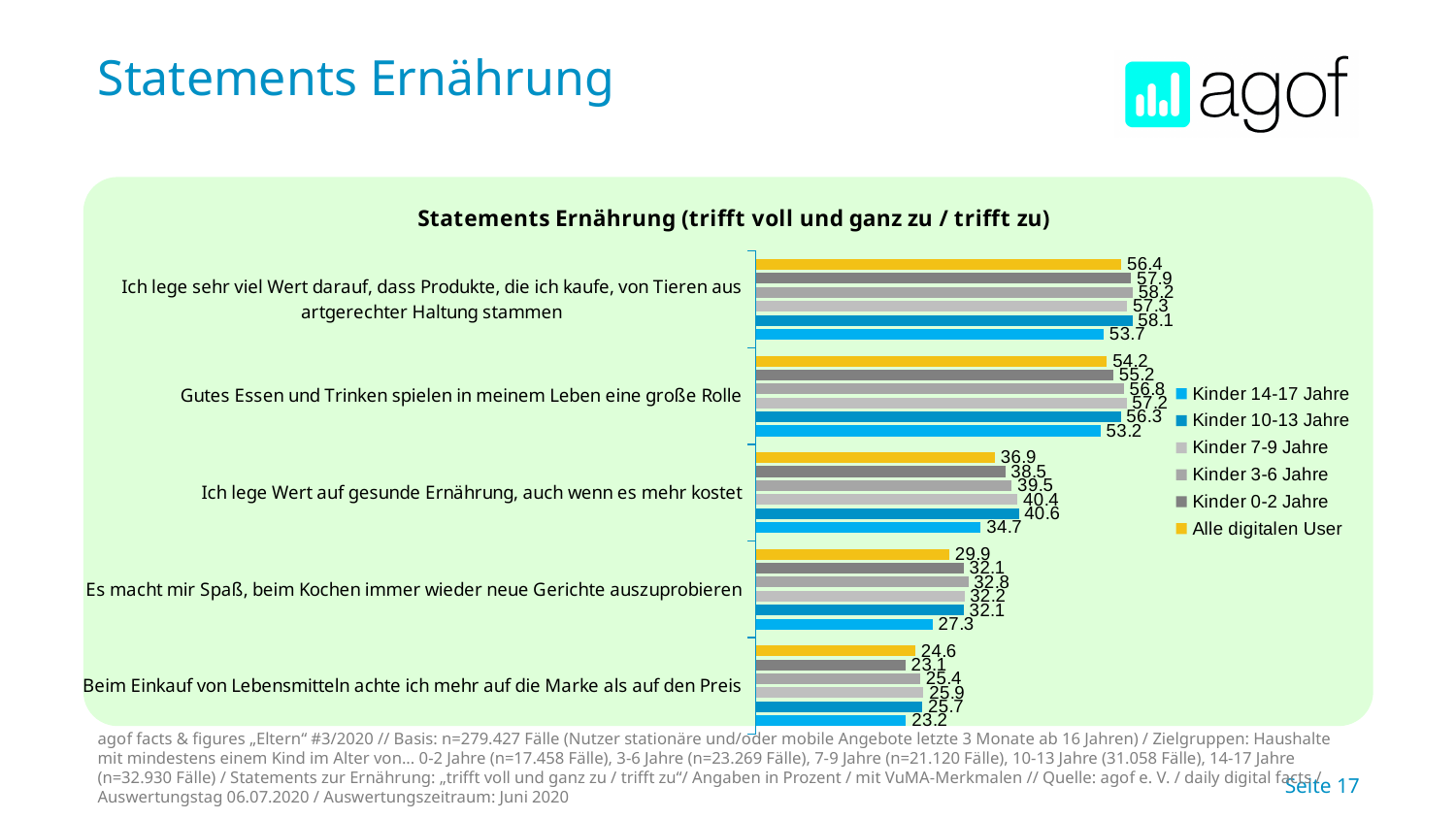
What is the value for 'Alle digitalen User' for the statement 'Ich lege Wert auf gesunde Ernährung, auch wenn es mehr kostet'? 36.9 For 'Alle digitalen User', which statement has the highest value? Ich lege sehr viel Wert darauf, dass Produkte, die ich kaufe, von Tieren aus artgerechter Haltung stammen What is the value for 'Kinder 14-17 Jahre' for the statement 'Gutes Essen und Trinken spielen in meinem Leben eine große Rolle'? 53.2 How many series does the legend list? 6 For 'Alle digitalen User', which statement has the lowest value? Beim Einkauf von Lebensmitteln achte ich mehr auf die Marke als auf den Preis For the statement 'Ich lege Wert auf gesunde Ernährung, auch wenn es mehr kostet', which is larger: the value for 'Alle digitalen User' or for 'Kinder 14-17 Jahre'? Alle digitalen User What is the value for 'Alle digitalen User' for the statement 'Beim Einkauf von Lebensmitteln achte ich mehr auf die Marke als auf den Preis'? 24.6 What is the value for 'Kinder 14-17 Jahre' for the statement 'Es macht mir Spaß, beim Kochen immer wieder neue Gerichte auszuprobieren'? 27.3 What is the difference between the 'Alle digitalen User' value (56.4) and the 'Kinder 14-17 Jahre' value (53.7) for the statement about 'artgerechter Haltung'? 2.7 How many statements (categories) are shown in the chart? 5 What type of chart is shown on the slide? bar chart What is the title of the chart? Statements Ernährung (trifft voll und ganz zu / trifft zu)